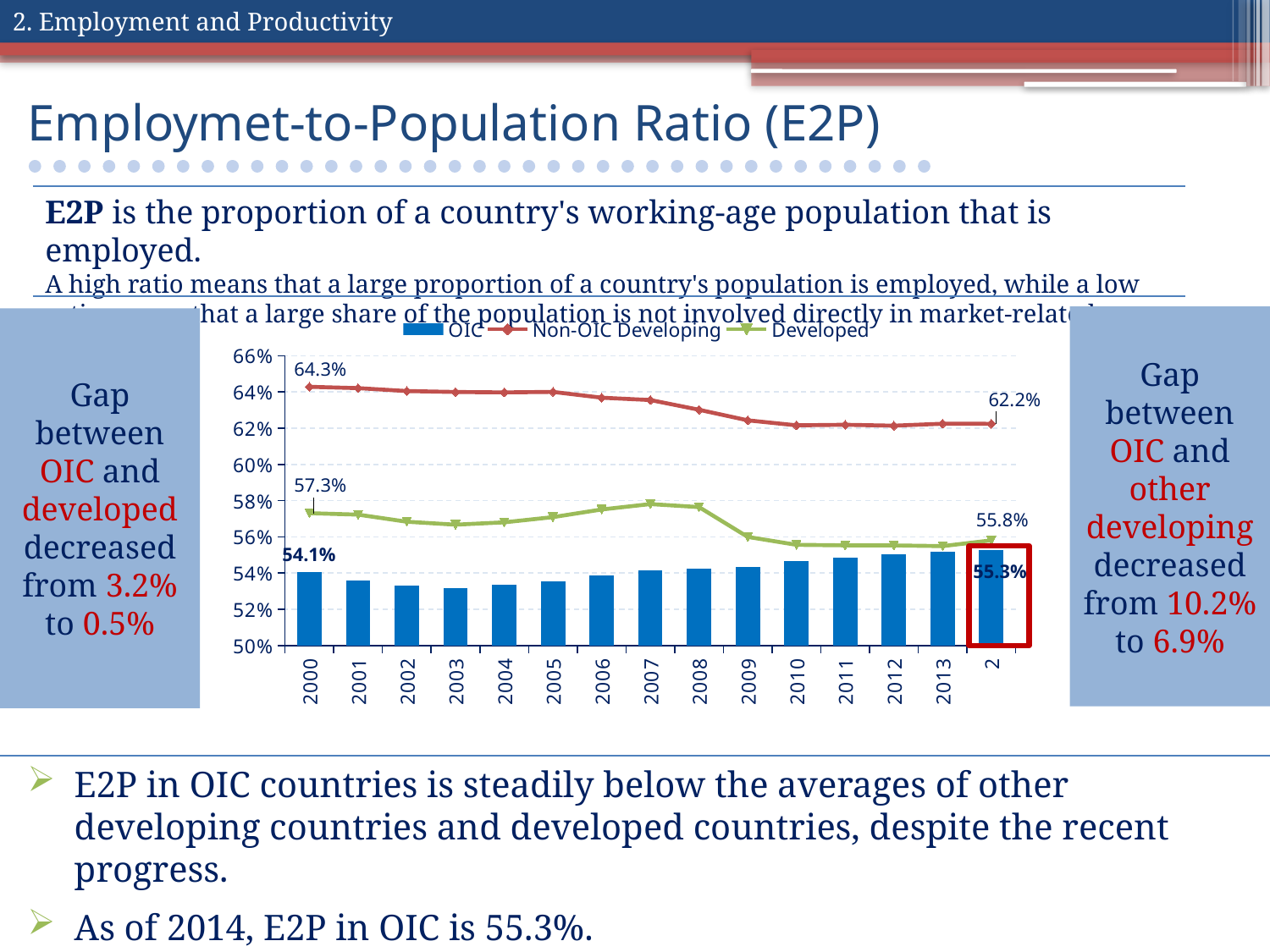
What value is labelled for Non-OIC Developing countries in 2000? 64.3% What kind of chart is used on this slide? Combined bar and line chart What value is labelled for Developed countries at the end of the series (2014)? 55.8% By how much did the OIC ratio rise from its 2000 label to its 2014 label? 1.2% Which series has the highest value in 2014? Non-OIC Developing What is the OIC employment-to-population ratio shown for 2000? 54.1% Is the Developed value for 2007 greater or less than 56%? greater Which series has the lowest value in 2000? OIC By how much did the Non-OIC Developing ratio fall between its 2000 label (64.3%) and its 2014 label (62.2%)? 2.1% In 2000, which was higher: the Non-OIC Developing ratio or the Developed ratio? Non-OIC Developing What is the OIC employment-to-population ratio shown for the last year (2014) in the chart? 55.3% How many series does the chart legend list? 3